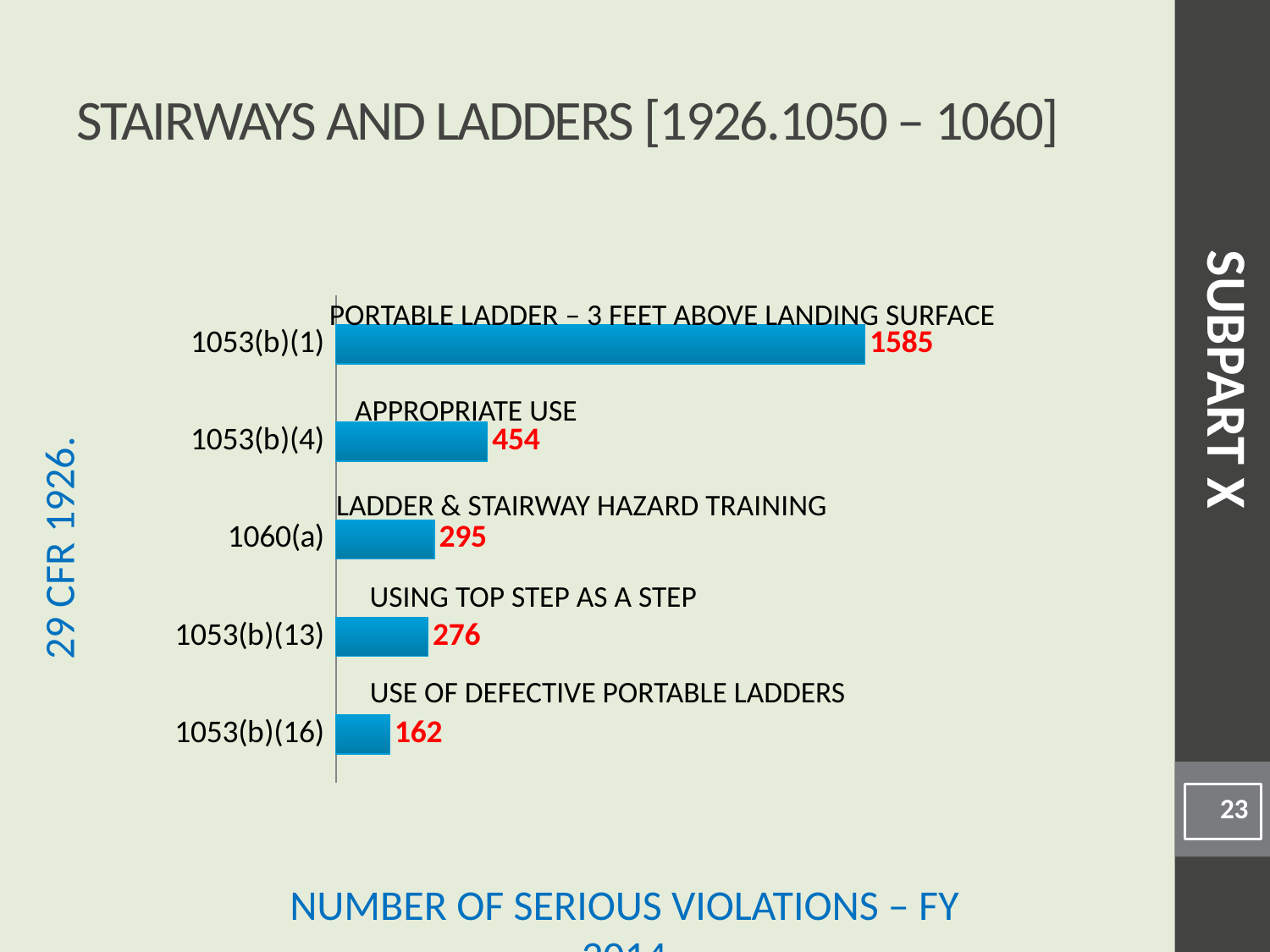
What is the number of serious violations for 1053(b)(4)? 454 What is the difference between the violations for 1060(a) and 1053(b)(13)? 19 What is the number of serious violations for 1053(b)(1)? 1585 Which has more serious violations, 1053(b)(13) or 1053(b)(16)? 1053(b)(13) What is the number of serious violations for 1053(b)(16)? 162 What description is given for the bar labelled 1053(b)(13)? USING TOP STEP AS A STEP Which standard has the highest number of serious violations? 1053(b)(1) What is the number of serious violations for 1060(a)? 295 What is the difference between the violations for 1053(b)(1) and 1053(b)(4)? 1131 How many standards are shown in the chart? 5 Which standard has the lowest number of serious violations? 1053(b)(16) What kind of chart is shown on the slide? Bar chart